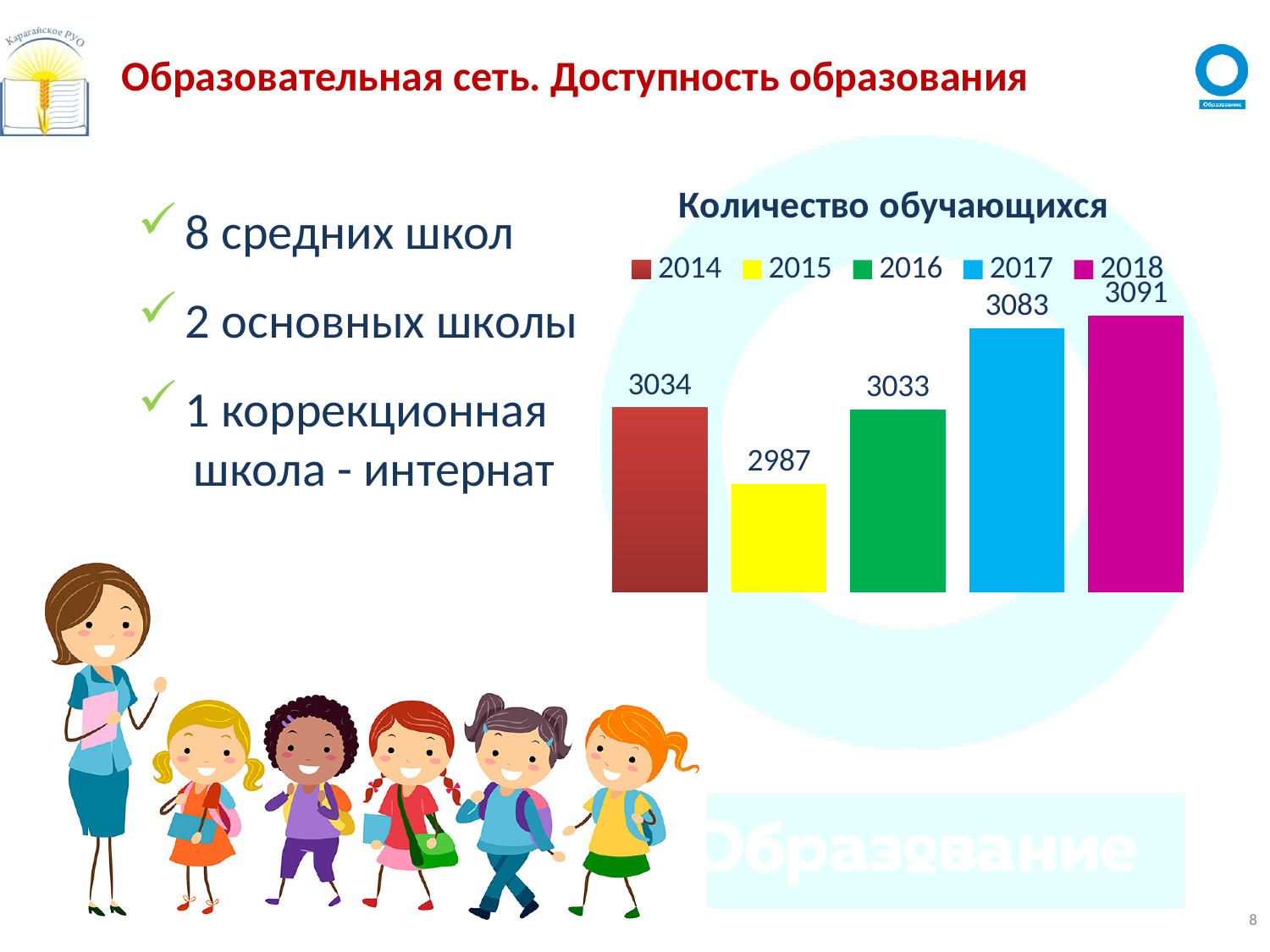
What is the difference between the values for 2018 and 2015? 104 How many years does the legend list? 5 Which is larger, the value for 2016 or the value for 2017? 2017 What is the value for 2014? 3034 What is the value for 2015? 2987 What is the value for 2018? 3091 Which year has the lowest value? 2015 Which year has the highest value? 2018 What type of chart is shown on the slide? bar chart What colour is the bar for 2017? blue What is the title of the chart? Количество обучающихся What is the value for 2017? 3083